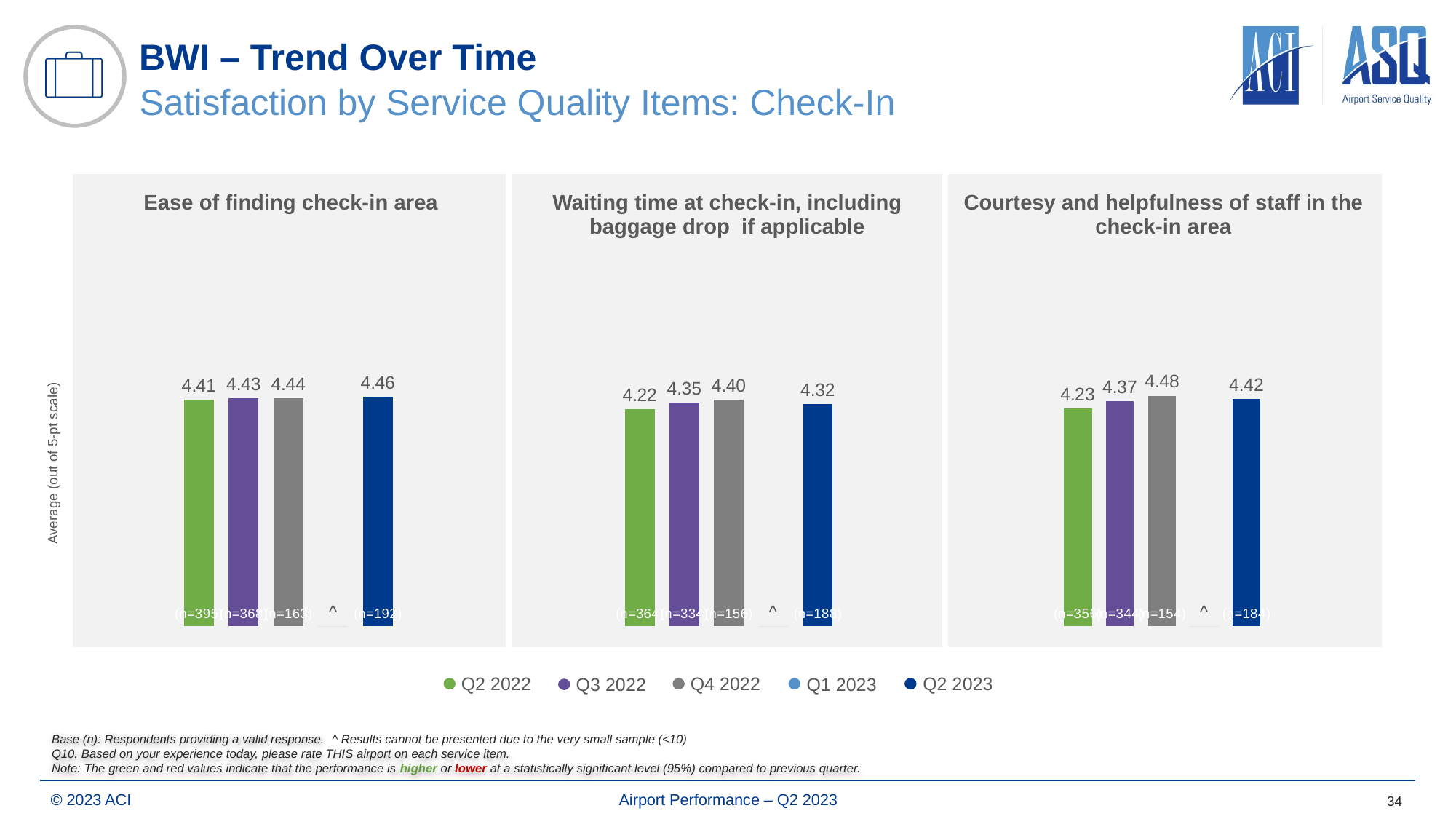
How many series does the legend list? 5 In the 'Ease of finding check-in area' chart, what is the difference between the Q2 2023 and Q2 2022 values? 0.05 In the 'Courtesy and helpfulness of staff in the check-in area' chart, what is the value for Q2 2022? 4.23 In the 'Ease of finding check-in area' chart, what is the value for Q2 2023? 4.46 In the 'Waiting time at check-in, including baggage drop if applicable' chart, which is larger: the Q4 2022 value or the Q2 2023 value? Q4 2022 In the 'Waiting time at check-in, including baggage drop if applicable' chart, what is the value for Q4 2022? 4.40 In the 'Courtesy and helpfulness of staff in the check-in area' chart, what is the difference between the Q4 2022 and Q2 2023 values? 0.06 In the 'Courtesy and helpfulness of staff in the check-in area' chart, which quarter has the highest value? Q4 2022 What kind of chart is used on this slide? Bar chart Which quarter in the legend has no bar shown in any of the three charts? Q1 2023 In the 'Ease of finding check-in area' chart, do the values rise or fall from Q2 2022 to Q4 2022? Rise In the 'Waiting time at check-in, including baggage drop if applicable' chart, which quarter has the lowest value? Q2 2022